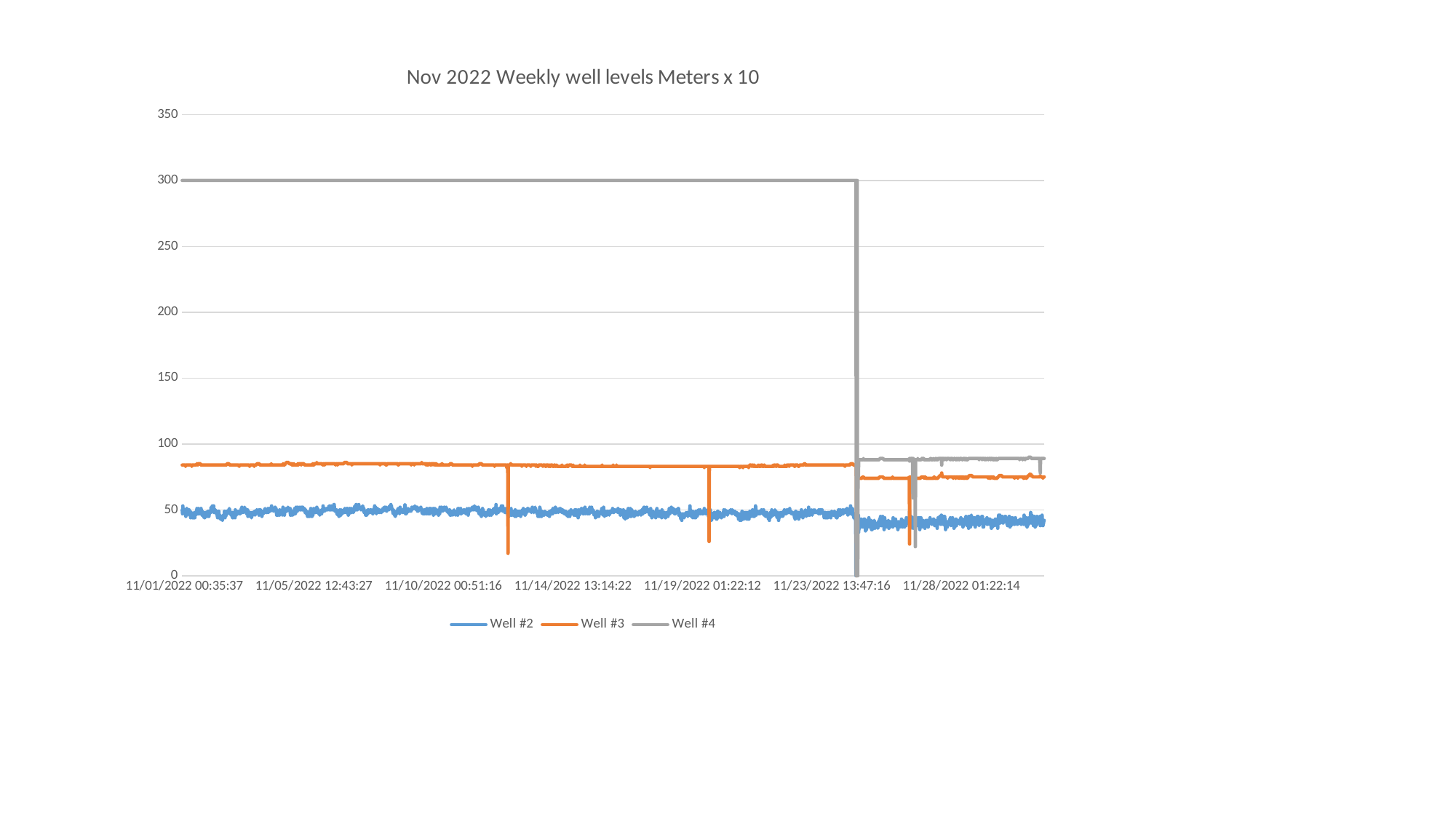
What is the title of the chart? Nov 2022 Weekly well levels Meters x 10 Which series is drawn in orange? Well #3 At 11/14/2022 13:14:22, which is larger, Well #2 or Well #3? Well #3 How many series does the legend list? 3 Which series has the lowest values for most of the period shown? Well #2 What kind of chart is shown on the slide? line chart Is the value for Well #2 at 11/05/2022 12:43:27 greater or less than 100? less Does the Well #4 line rise or fall from the start of the period to the end? fall Is the value for Well #4 at 11/10/2022 00:51:16 greater or less than 250? greater Is the value for Well #4 at 11/28/2022 01:22:14 greater or less than 150? less Which series has the highest values for most of the period shown? Well #4